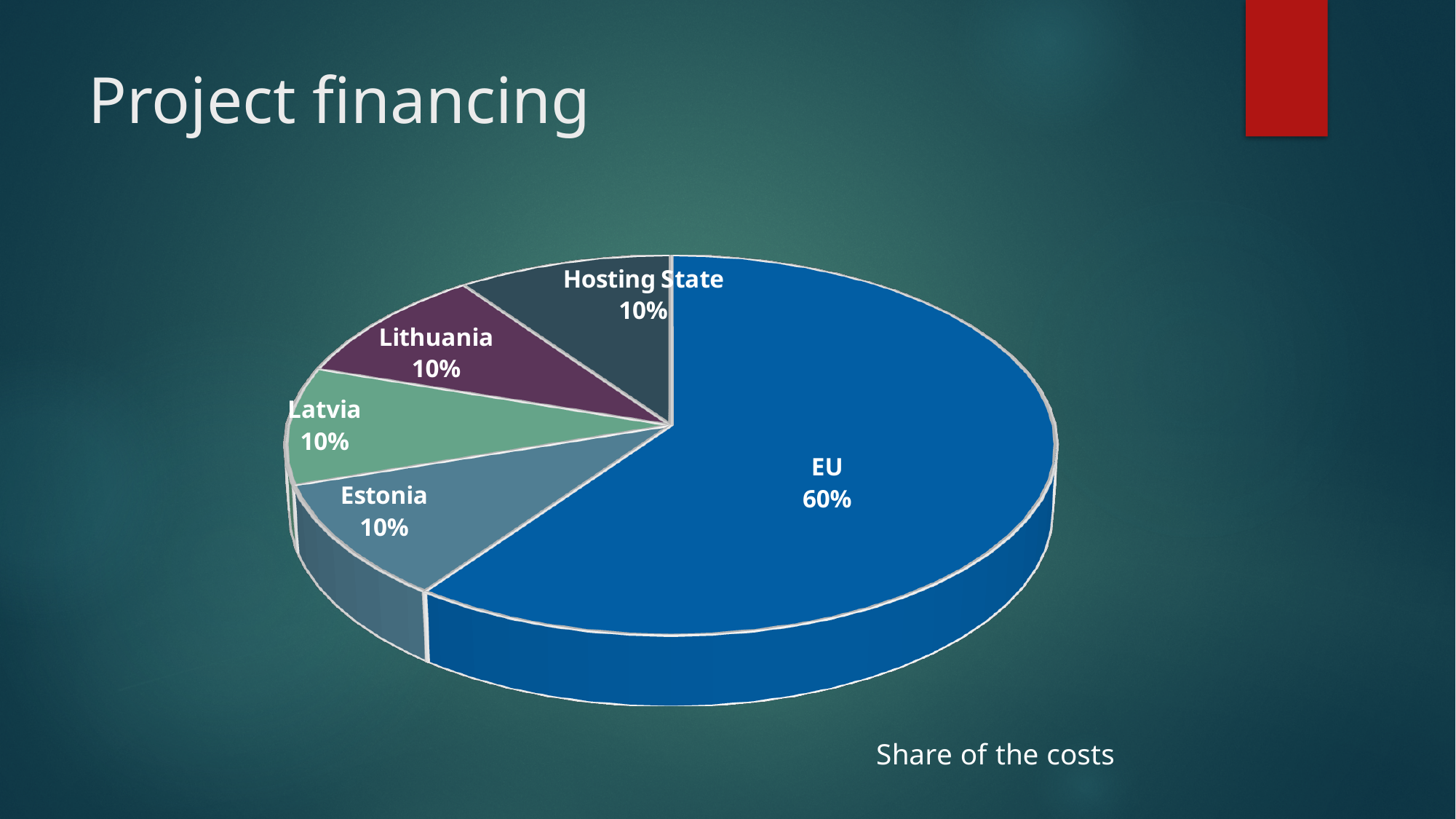
What kind of chart is shown on the slide? Pie chart What is the combined share of Estonia, Latvia and Lithuania? 30% What is the difference between the EU's share and Latvia's share? 50% What share of the costs does Estonia cover? 10% How many slices does the pie chart have? 5 What share of the costs does Lithuania cover? 10% What share of the costs does the Hosting State cover? 10% Which contributor has the largest share of the costs? EU Which is larger, the EU's share or Estonia's share? EU What is the title of the slide containing the chart? Project financing What share of the costs does the EU cover? 60% What caption appears below the pie chart? Share of the costs